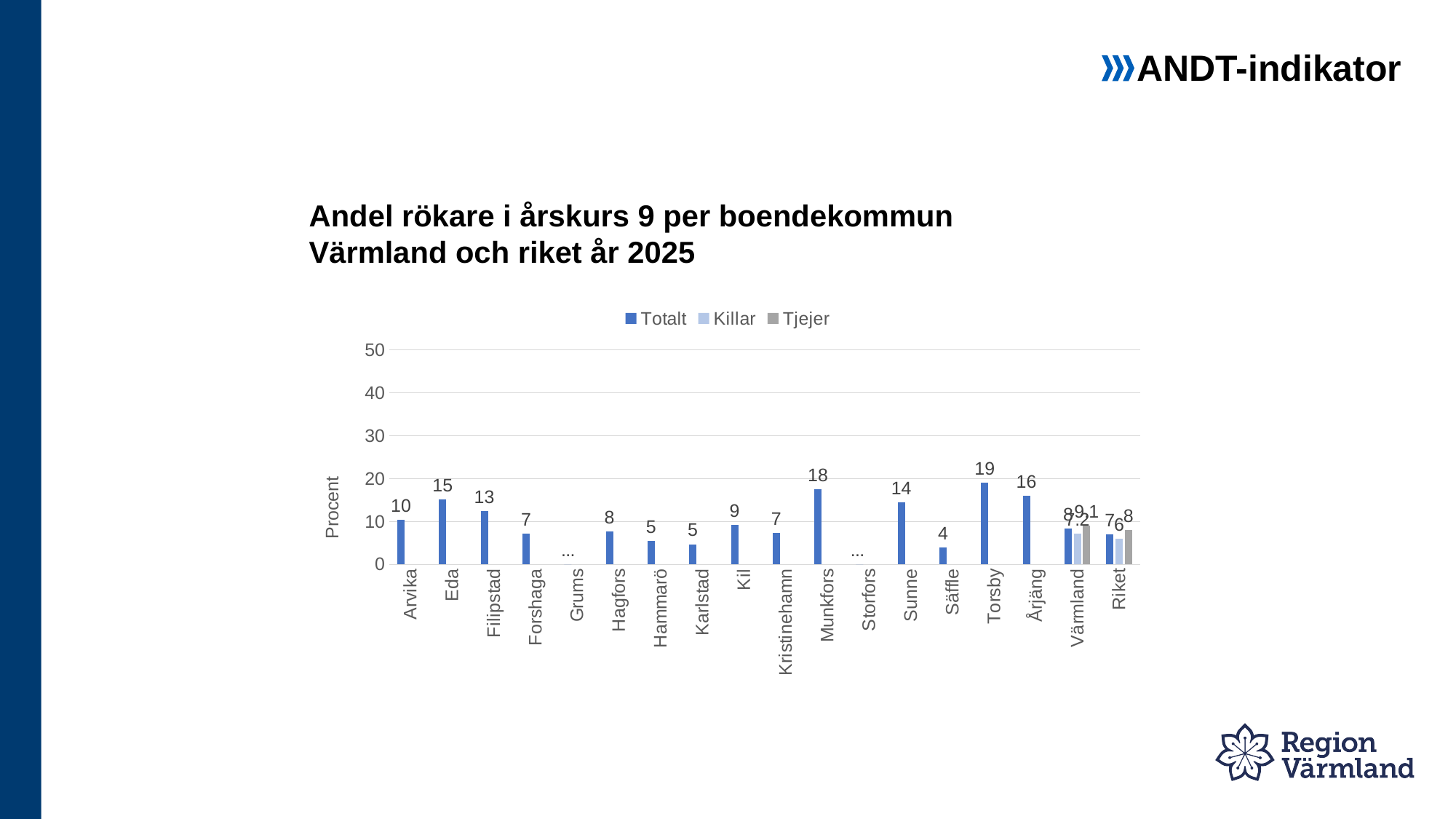
Is the Totalt value for Årjäng greater or less than 10? greater What is the value for Munkfors (Totalt)? 18 What is the value for Säffle (Totalt)? 4 What is the label of the y axis? Procent What kind of chart is shown on the slide? Bar chart How many series does the legend list? 3 What is the value for Torsby (Totalt)? 19 Which municipality has the lowest labelled Totalt value? Säffle Which has a larger Totalt value, Sunne or Filipstad? Sunne How many categories are shown on the x axis? 18 Which municipality has the highest Totalt value? Torsby What is the difference between the Totalt values for Eda and Arvika? 5